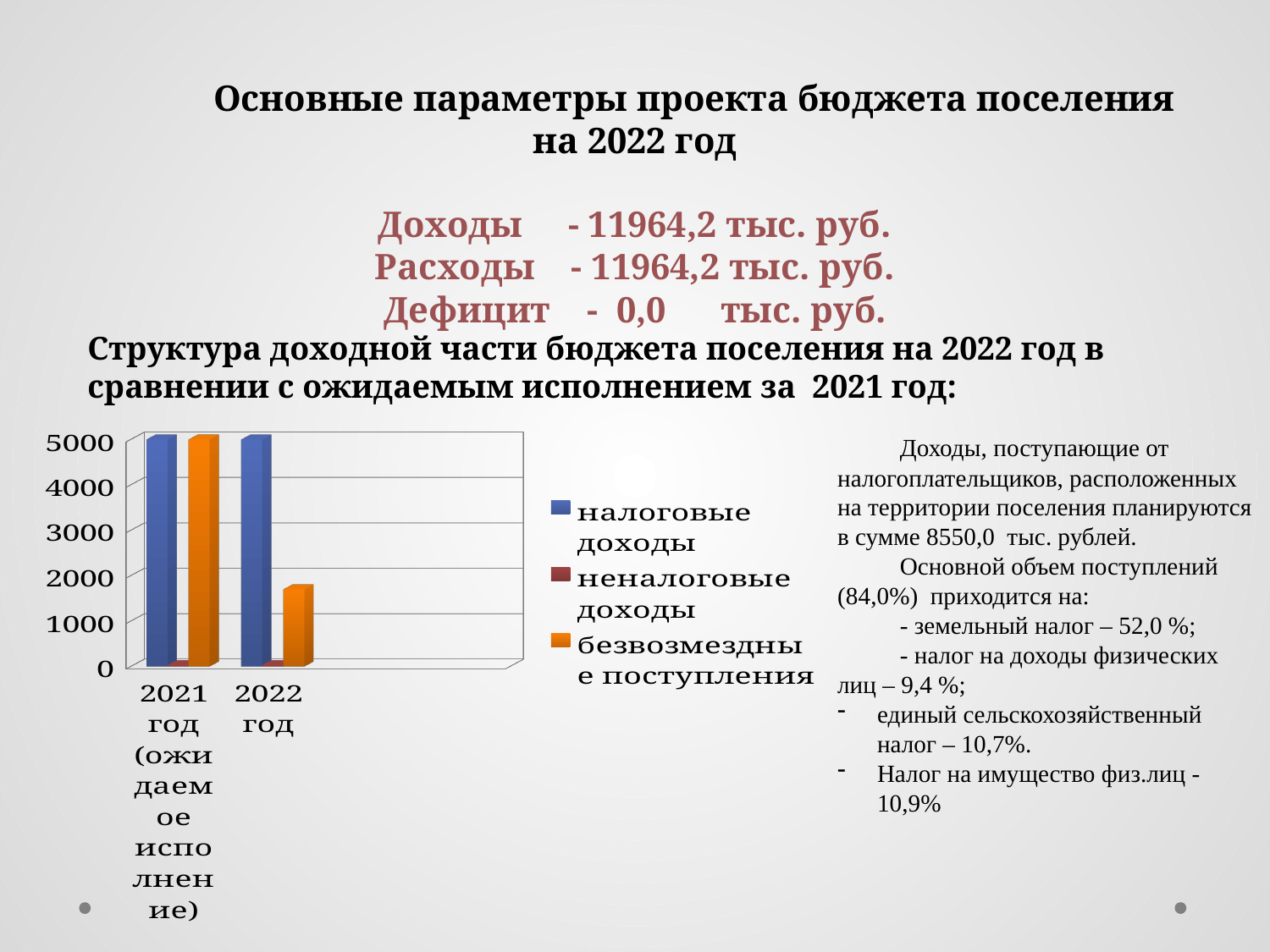
Is the value for неналоговые доходы in 2022 год greater or less than 1000? less Is the value for безвозмездные поступления in 2022 год greater or less than 1000? greater How many categories are shown on the x axis of the chart? 2 Do the values for безвозмездные поступления rise or fall from 2021 год to 2022 год? fall Which series has the lowest value in 2022 год? неналоговые доходы Which series is shown in blue in the chart? налоговые доходы Which series is shown in orange in the chart? безвозмездные поступления What kind of chart is shown on the slide? bar chart Is the value for налоговые доходы in 2022 год greater or less than 4000? greater How many series does the chart's legend list? 3 Which is larger: безвозмездные поступления in 2021 год or in 2022 год? 2021 год